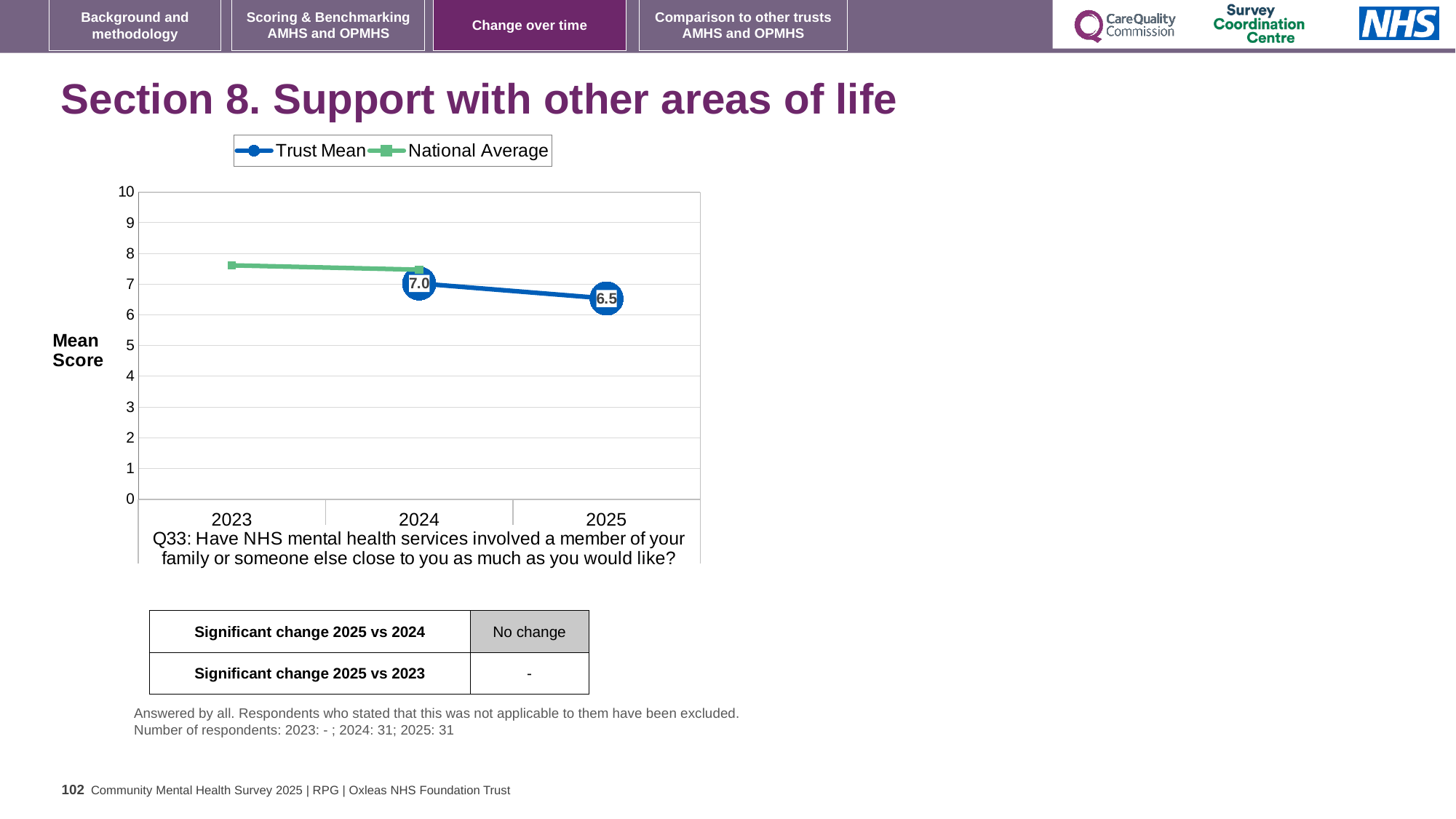
What are the two series named in the legend? Trust Mean and National Average What kind of chart is shown on the slide? line chart Is the National Average value for 2023 greater or less than 8? less Which year has the higher Trust Mean, 2024 or 2025? 2024 By how much did the Trust Mean fall from 2024 to 2025? 0.5 What is the Trust Mean value for 2025? 6.5 Does the Trust Mean rise or fall from 2024 to 2025? fall How many series does the legend list? 2 How many years are shown on the x axis? 3 Is the National Average value for 2023 greater or less than 7? greater What is the Trust Mean value for 2024? 7.0 What is the label on the y axis of the chart? Mean Score